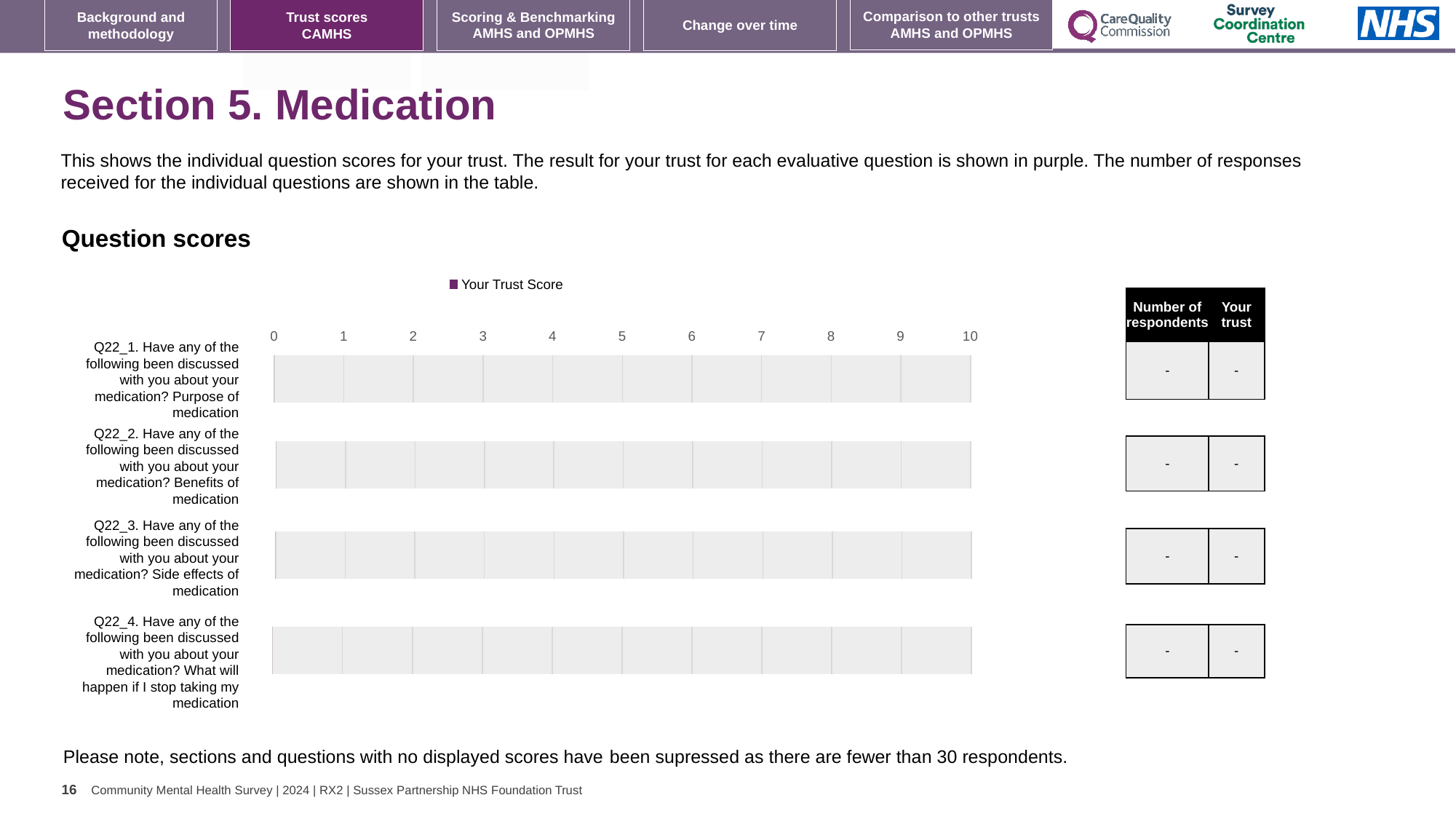
What is shown in the 'Number of respondents' column for Q22_1? - What is shown in the 'Your trust' column for Q22_4? - Which question label is listed last (at the bottom) on the chart? Q22_4. Have any of the following been discussed with you about your medication? What will happen if I stop taking my medication How many series does the chart legend list? 1 What kind of chart is shown under 'Question scores'? bar chart How many question categories are listed on the chart's vertical axis? 4 What is the name of the series shown in the chart legend? Your Trust Score What is the maximum value shown on the chart's horizontal axis? 10